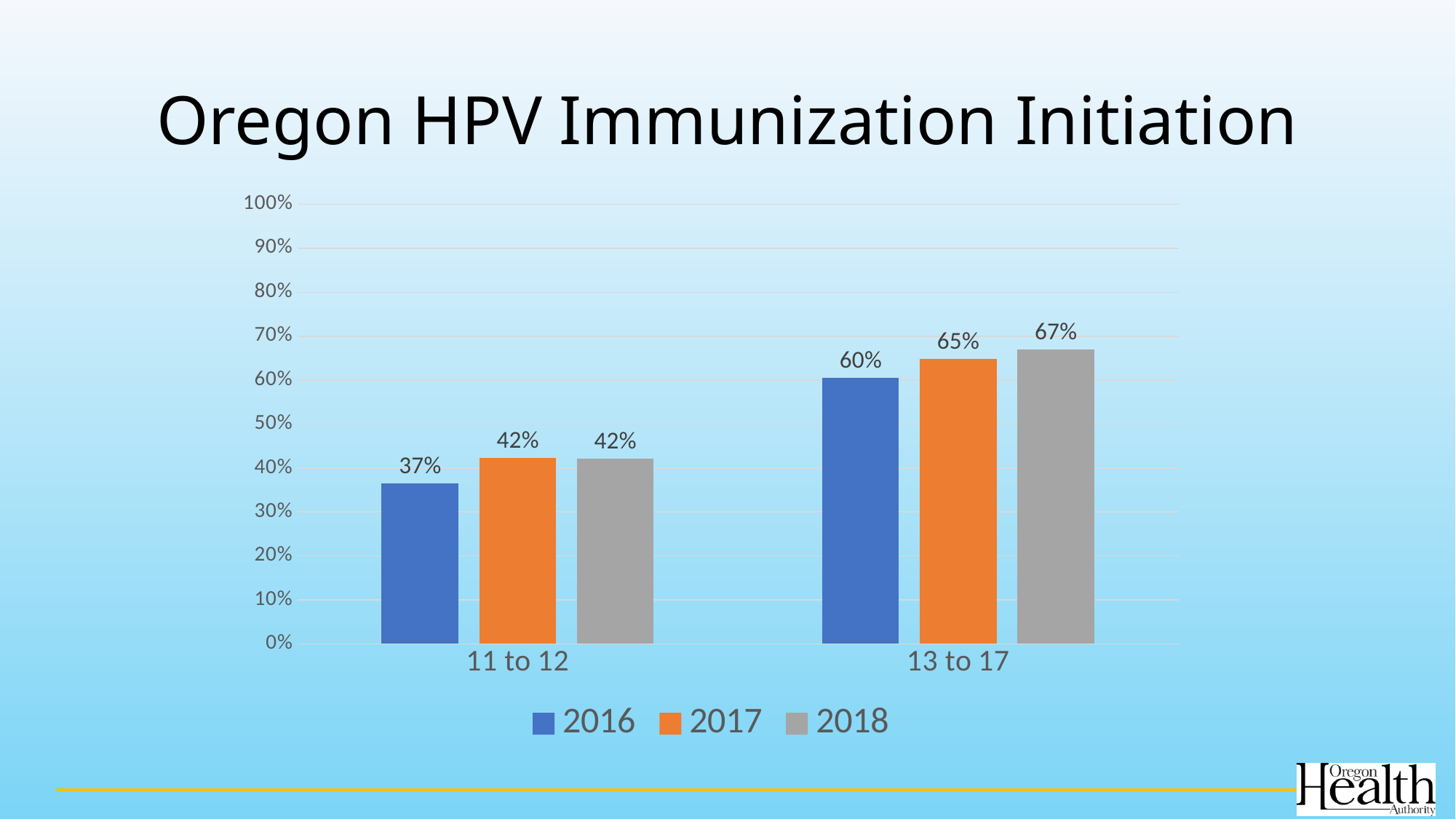
What is the difference between the 2017 and 2016 values for the 11 to 12 age group? 5% Which is larger, the 2016 value for 11 to 12 or the 2016 value for 13 to 17? 13 to 17 What kind of chart is shown on the slide? Bar chart Which year has the highest value for the 13 to 17 age group? 2018 How many age group categories are shown on the x axis? 2 What is the 2017 value for the 13 to 17 age group? 65% How many series does the legend list? 3 Which year has the lowest value for the 11 to 12 age group? 2016 What is the difference between the 2018 and 2016 values for the 13 to 17 age group? 7% What is the 2016 value for the 11 to 12 age group? 37% Is the 2017 value for the 13 to 17 age group greater or less than 50%? greater What is the 2018 value for the 13 to 17 age group? 67%